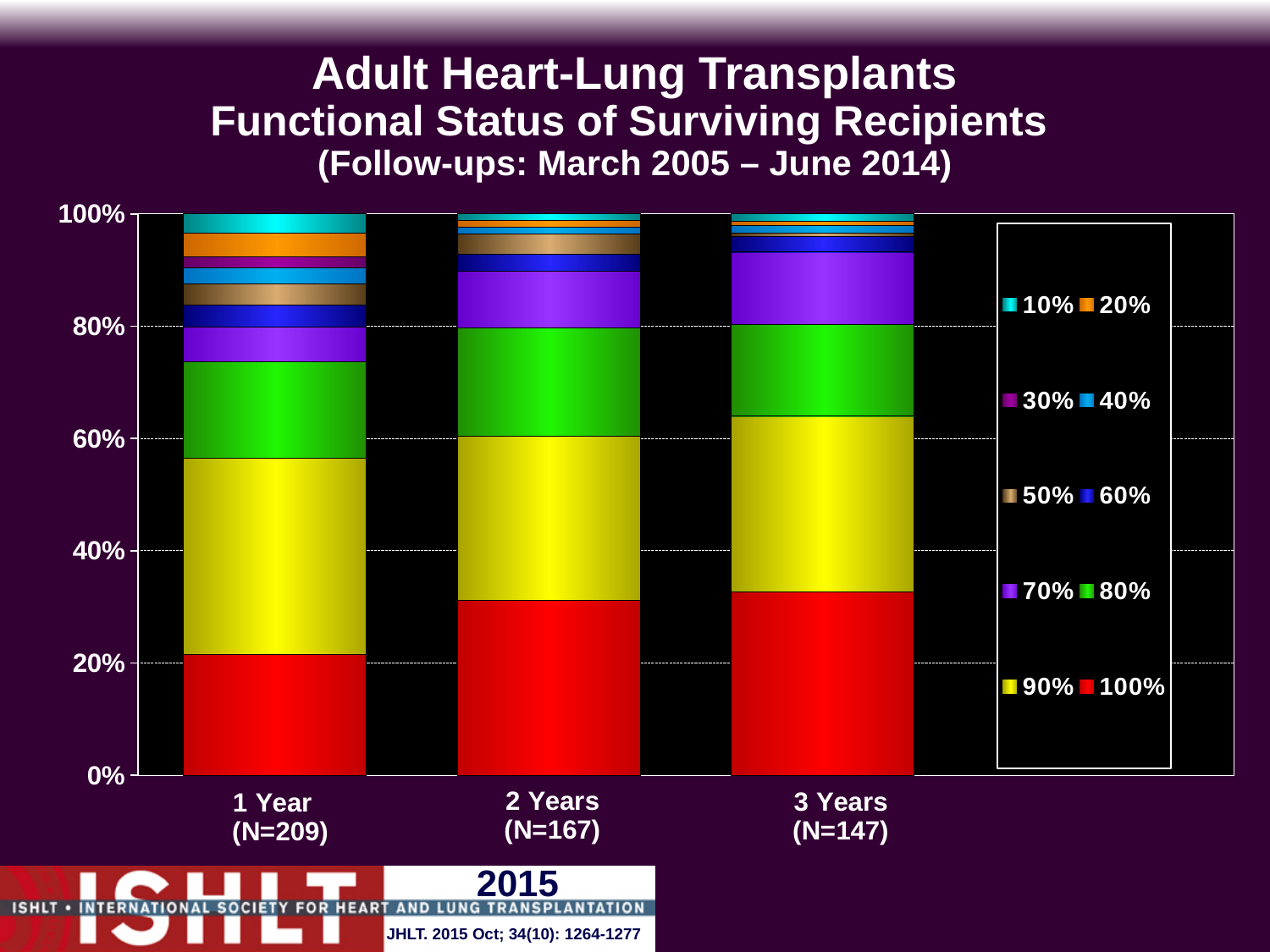
What is the total height of each stacked bar on the y axis? 100% What kind of chart is shown on the slide? Stacked bar chart What follow-up period is stated in the chart title? March 2005 – June 2014 What is the sample size (N) shown for the 3 Years category? N=147 Which has a larger 100% functional status (red) segment: 1 Year or 3 Years? 3 Years How many series does the legend list? 10 What is the sample size (N) shown for the 1 Year category? N=209 Is the share of the 100% functional status segment for 3 Years greater or less than 40%? less How many follow-up time points (categories) are plotted on the x axis? 3 Is the combined share of the 100% and 90% segments for 1 Year greater or less than 60%? less What is the sample size (N) shown for the 2 Years category? N=167 Is the share of the 100% functional status segment for 2 Years greater or less than 20%? greater